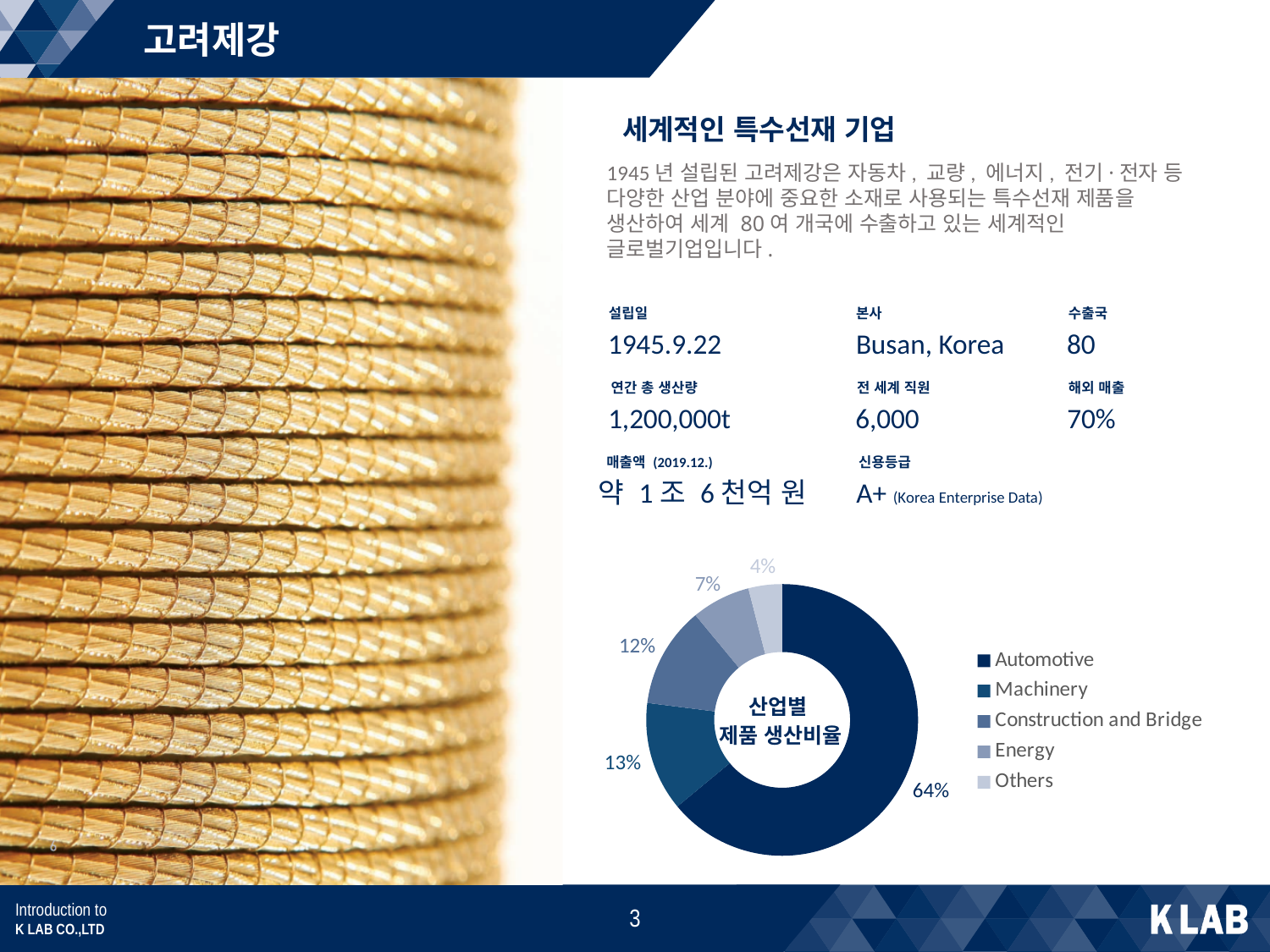
Which has a larger share, Energy or Construction and Bridge? Construction and Bridge What share of production does Others account for in the pie chart? 4% What share of production does Energy account for in the pie chart? 7% What kind of chart is shown on the slide? Pie chart (donut) Which category has the smallest share in the pie chart? Others What share of production does Automotive account for in the pie chart? 64% What share of production does Machinery account for in the pie chart? 13% What share of production does Construction and Bridge account for in the pie chart? 12% What is the difference in percentage points between the Automotive share and the Machinery share? 51 Which category has the largest share in the pie chart? Automotive How many categories does the legend of the pie chart list? 5 What text is written in the centre of the donut chart? 산업별 제품 생산비율